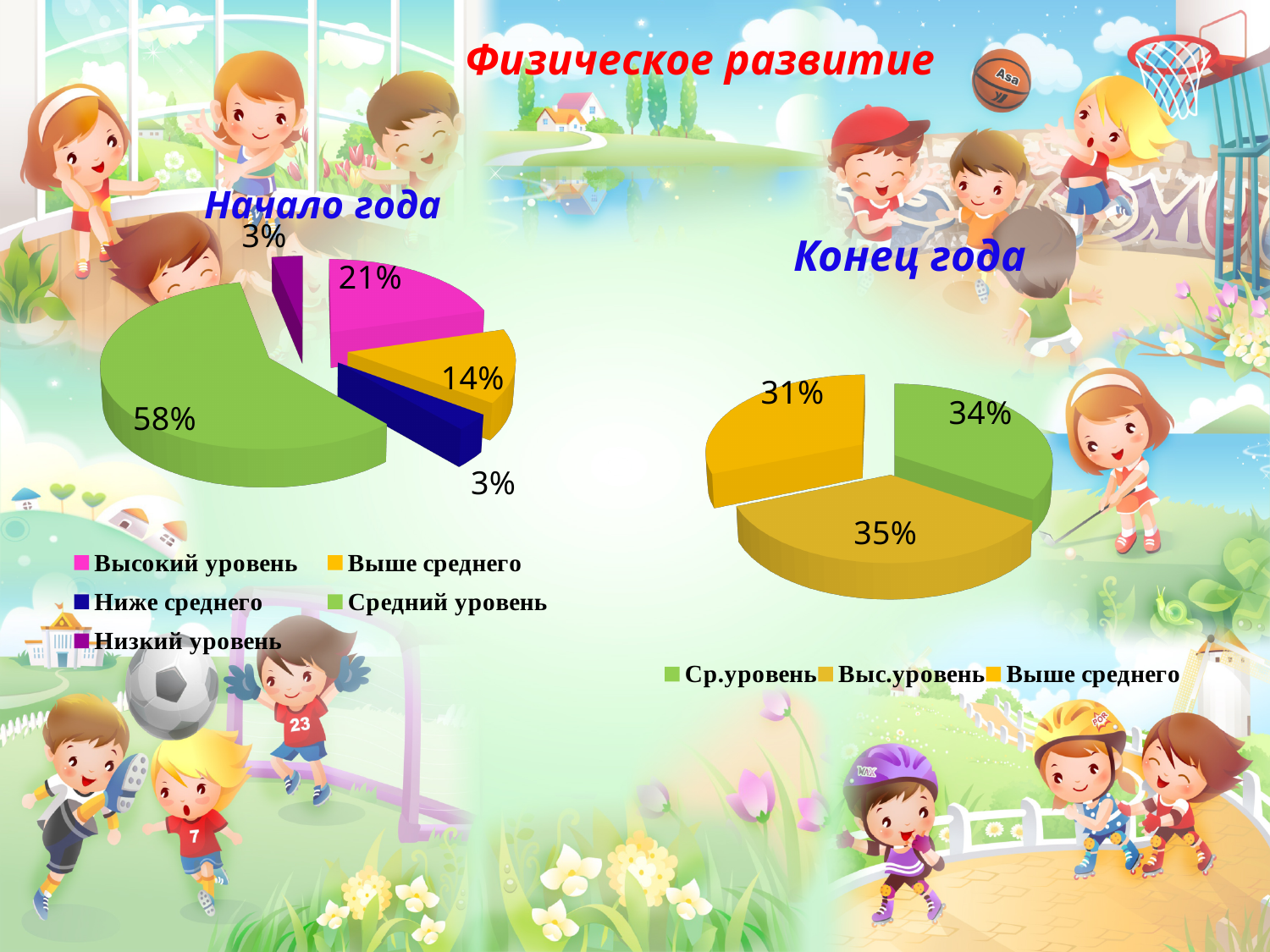
In the "Конец года" chart, what percentage is shown for Ср.уровень? 34% In the "Конец года" chart, how many slices does the pie have? 3 In the "Начало года" chart, what percentage is shown for Средний уровень? 58% In the "Начало года" chart, which colour represents Низкий уровень? Purple In the "Конец года" chart, which category has the smallest share? Выше среднего In the "Начало года" chart, what is the difference between the Высокий уровень and Выше среднего shares? 7% What type of chart is used for "Конец года"? Pie chart In the "Конец года" chart, what percentage is shown for Выше среднего? 31% In the "Начало года" chart, what percentage is shown for Высокий уровень? 21% In the "Начало года" chart, what percentage is shown for Выше среднего? 14% In the "Начало года" chart, which category has the largest share? Средний уровень In the "Начало года" chart, how many categories does the legend list? 5